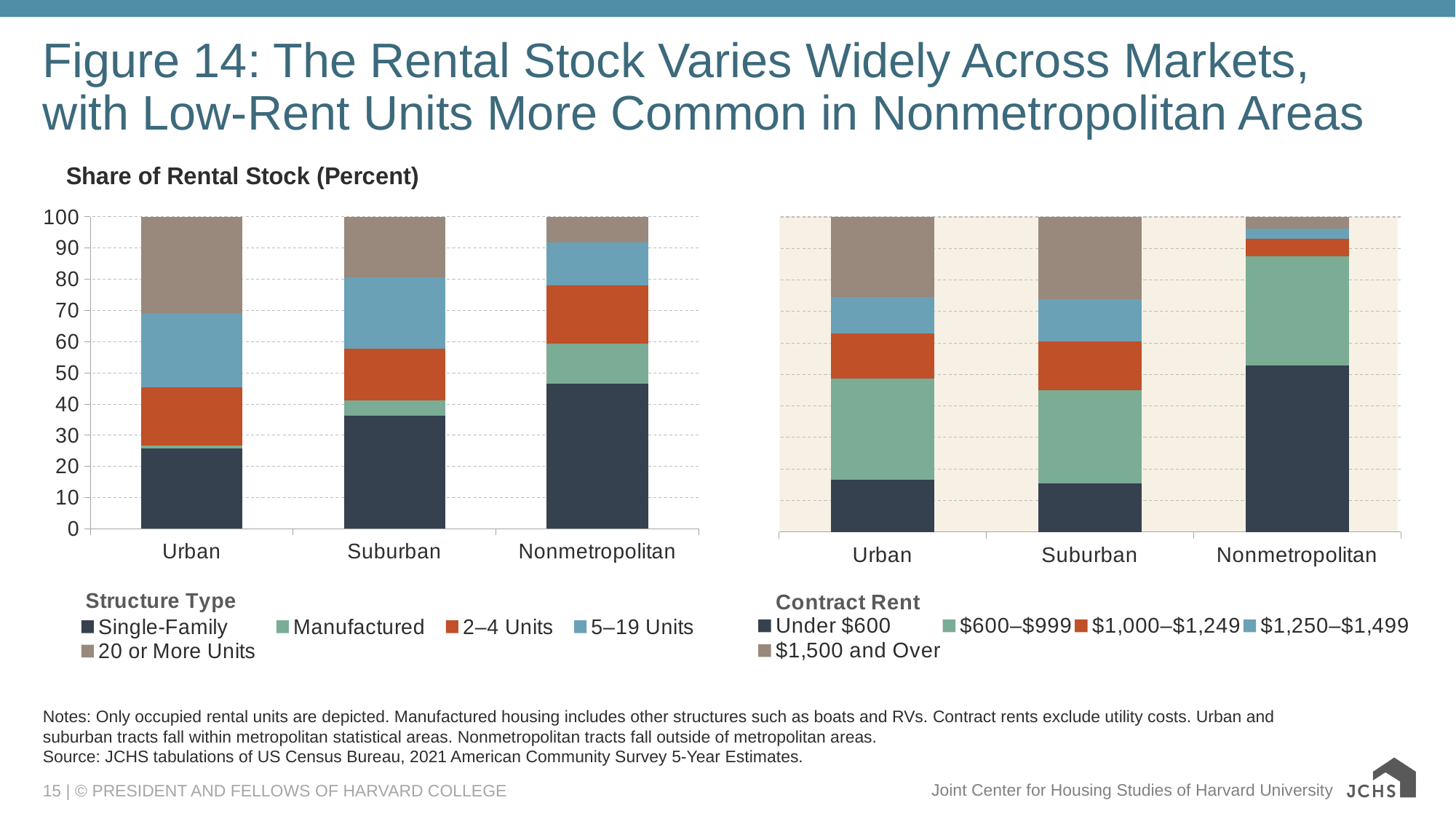
In the left chart (Structure Type), does the Single-Family share rise or fall moving from Urban to Suburban to Nonmetropolitan? Rises In the left chart (Structure Type), is the Single-Family share for Urban greater or less than 30? less In the left chart (Structure Type), is the Single-Family share for Nonmetropolitan greater or less than 40? greater What kind of chart is the left chart (Structure Type)? Stacked bar chart In the left chart (Structure Type), which category has the largest share of 20 or More Units? Urban In the right chart (Contract Rent), which category has the largest share of units renting for Under $600? Nonmetropolitan In the left chart (Structure Type), is the Manufactured share larger for Nonmetropolitan or for Urban? Nonmetropolitan How many series does the legend of the right chart (Contract Rent) list? 5 In the left chart (Structure Type), which category has the largest Single-Family share? Nonmetropolitan How many series does the legend of the left chart (Structure Type) list? 5 How many categories are shown on the x axis of the left chart (Structure Type)? 3 In the right chart (Contract Rent), which category has the smallest share of units renting for $1,500 and Over? Nonmetropolitan